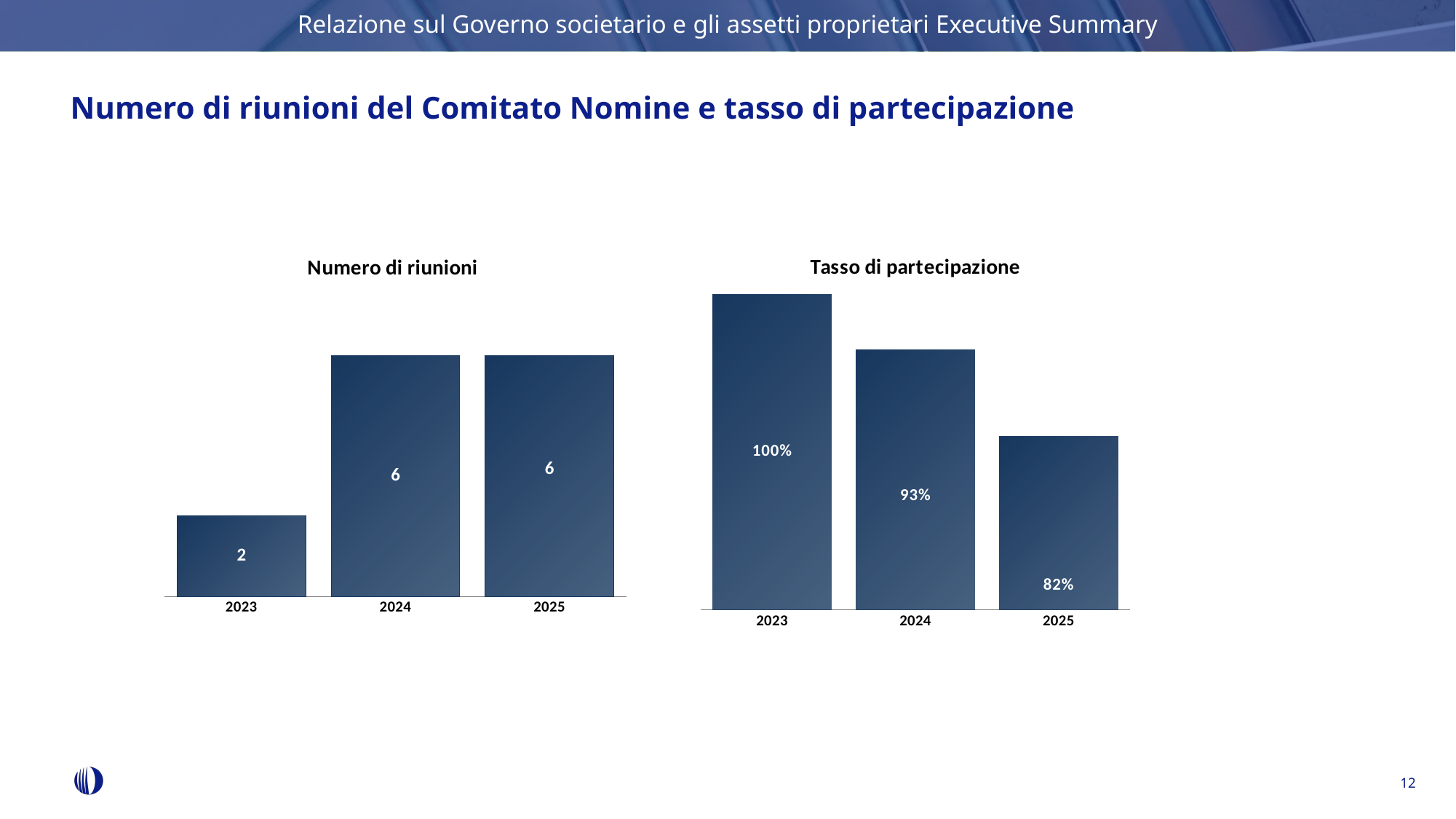
What kind of chart is the 'Tasso di partecipazione' chart? Bar chart In the 'Tasso di partecipazione' chart, what is the value for 2024? 93% In the 'Tasso di partecipazione' chart, which is larger, the value for 2024 or the value for 2025? 2024 In the 'Numero di riunioni' chart, which year has the lowest value? 2023 In the 'Tasso di partecipazione' chart, which year has the lowest value? 2025 In the 'Numero di riunioni' chart, what is the value for 2024? 6 In the 'Numero di riunioni' chart, what is the value for 2023? 2 In the 'Tasso di partecipazione' chart, what is the value for 2025? 82% In the 'Numero di riunioni' chart, what is the difference between the values for 2024 and 2023? 4 In the 'Tasso di partecipazione' chart, what is the difference between the values for 2023 and 2025? 18% In the 'Tasso di partecipazione' chart, which year has the highest value? 2023 How many categories are shown in the 'Numero di riunioni' chart? 3